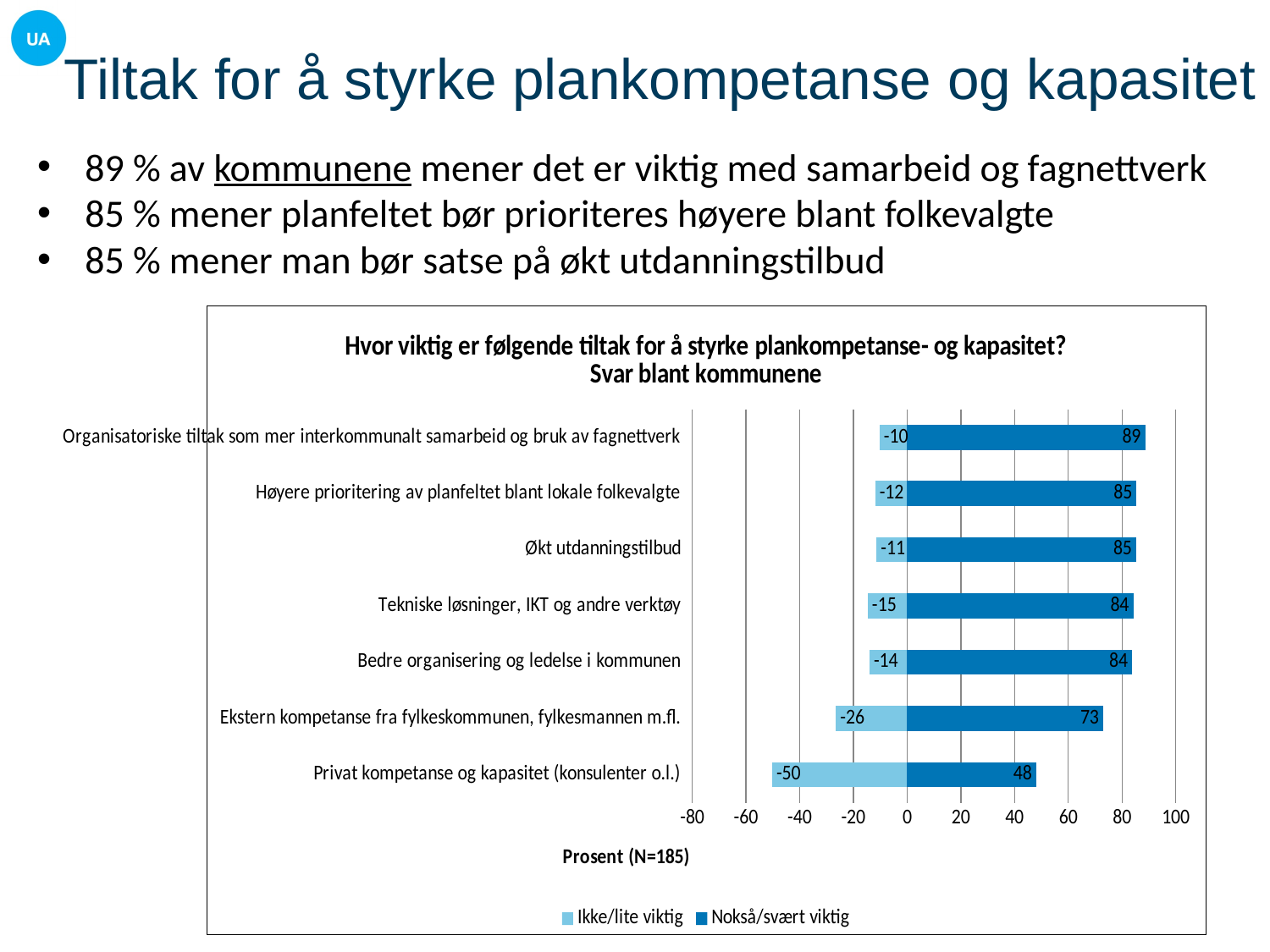
Which category has the highest 'Nokså/svært viktig' value? Organisatoriske tiltak som mer interkommunalt samarbeid og bruk av fagnettverk What is the x-axis label of the chart? Prosent (N=185) What is the difference between the 'Nokså/svært viktig' values for 'Organisatoriske tiltak som mer interkommunalt samarbeid og bruk av fagnettverk' and 'Privat kompetanse og kapasitet (konsulenter o.l.)'? 41 How many categories are shown in the chart? 7 Which has a larger 'Nokså/svært viktig' value: 'Ekstern kompetanse fra fylkeskommunen, fylkesmannen m.fl.' or 'Tekniske løsninger, IKT og andre verktøy'? Tekniske løsninger, IKT og andre verktøy What is the 'Ikke/lite viktig' value for 'Tekniske løsninger, IKT og andre verktøy'? -15 What kind of chart is shown on the slide? Bar chart What is the 'Ikke/lite viktig' value for 'Ekstern kompetanse fra fylkeskommunen, fylkesmannen m.fl.'? -26 What is the 'Ikke/lite viktig' value for 'Privat kompetanse og kapasitet (konsulenter o.l.)'? -50 Which category has the lowest 'Nokså/svært viktig' value? Privat kompetanse og kapasitet (konsulenter o.l.) What is the 'Nokså/svært viktig' value for 'Økt utdanningstilbud'? 85 How many series does the legend list? 2